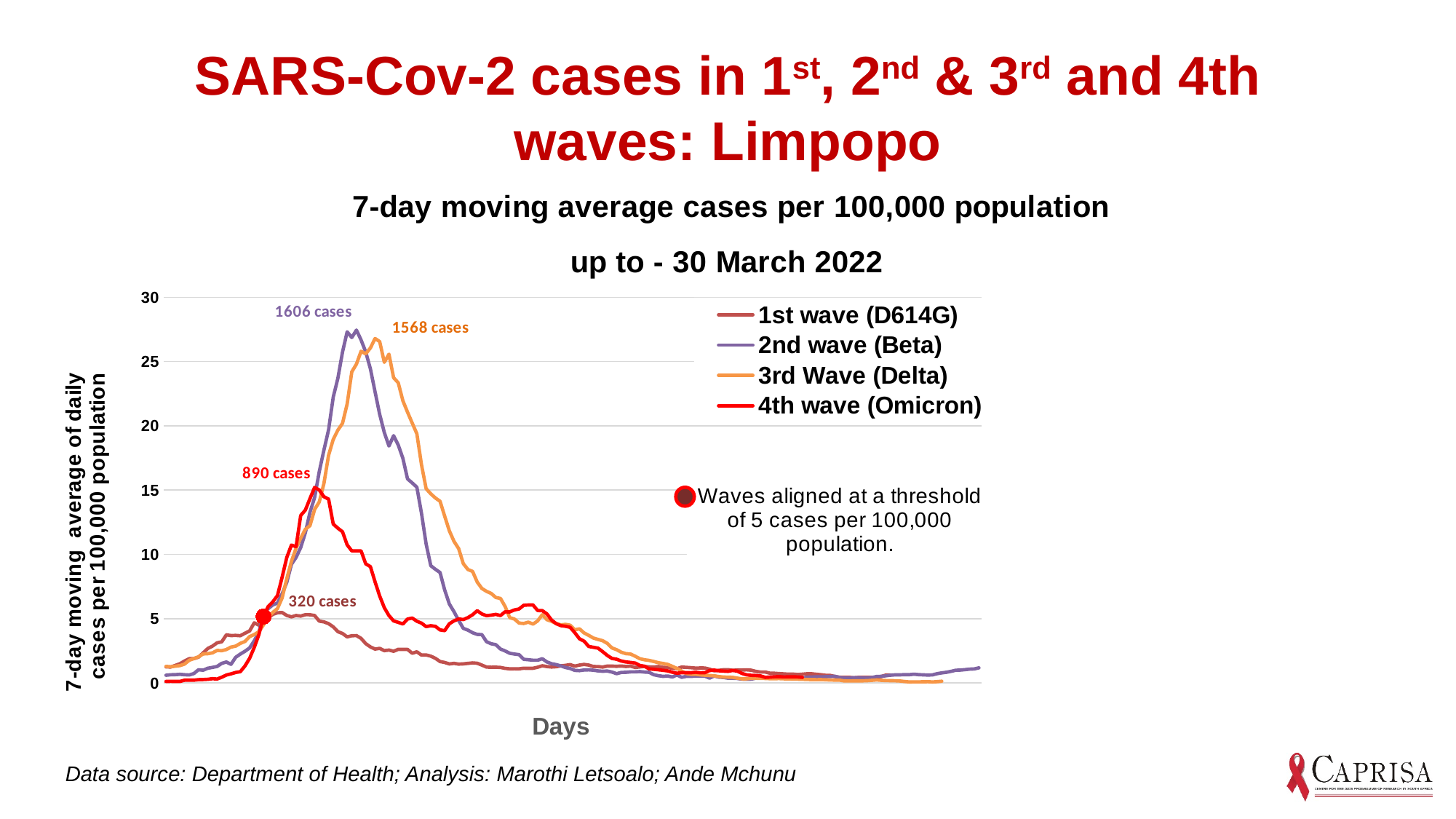
Is the peak of the 1st wave (D614G) line greater or less than 10 cases per 100,000? less What kind of chart is shown on the slide? line chart What peak case count is labelled for the 2nd wave (Beta)? 1606 cases What peak case count is labelled for the 1st wave (D614G)? 320 cases How many series does the legend list? 4 Is the peak of the 4th wave (Omicron) line greater or less than 10 cases per 100,000? greater Which wave has the lowest labelled peak case count? 1st wave (D614G) What peak case count is labelled for the 3rd Wave (Delta)? 1568 cases At what threshold of cases per 100,000 population are the waves aligned? 5 cases per 100,000 population What is the difference between the labelled peak case counts of the 2nd wave and the 3rd wave? 38 cases Which wave has the highest labelled peak case count? 2nd wave (Beta) What peak case count is labelled for the 4th wave (Omicron)? 890 cases